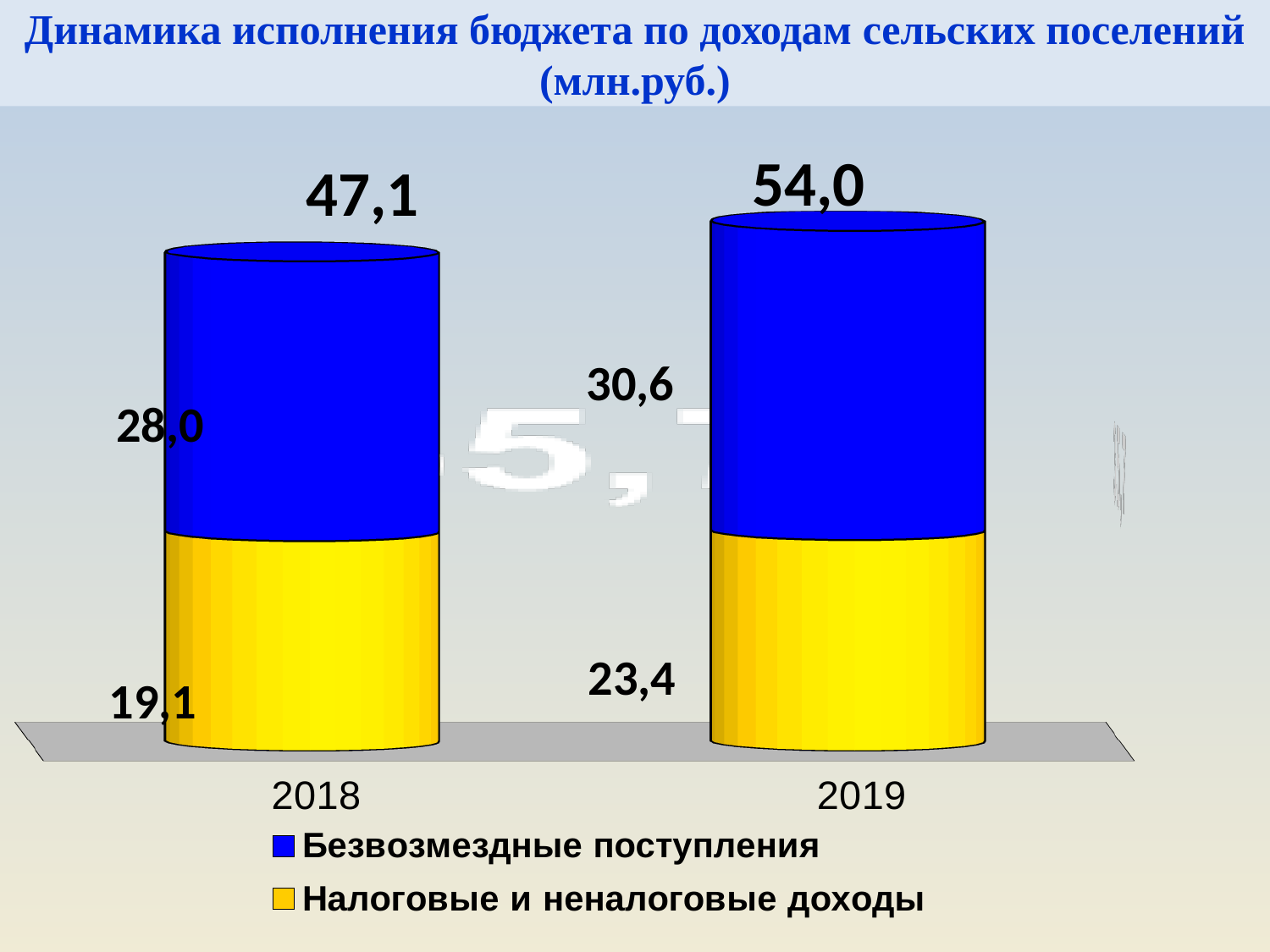
What kind of chart is shown on the slide? Stacked bar chart How many years (categories) are shown on the x axis? 2 How many series does the legend list? 2 What is the value of Налоговые и неналоговые доходы for 2018? 19,1 What is the difference between the totals for 2019 and 2018? 6,9 Which is larger: Безвозмездные поступления in 2018 or Налоговые и неналоговые доходы in 2018? Безвозмездные поступления What is the value of Безвозмездные поступления for 2019? 30,6 What is the value of Безвозмездные поступления for 2018? 28,0 What is the value of Налоговые и неналоговые доходы for 2019? 23,4 What is the total of the stacked bar for 2019? 54,0 What is the total of the stacked bar for 2018? 47,1 Which year has the higher total revenue? 2019